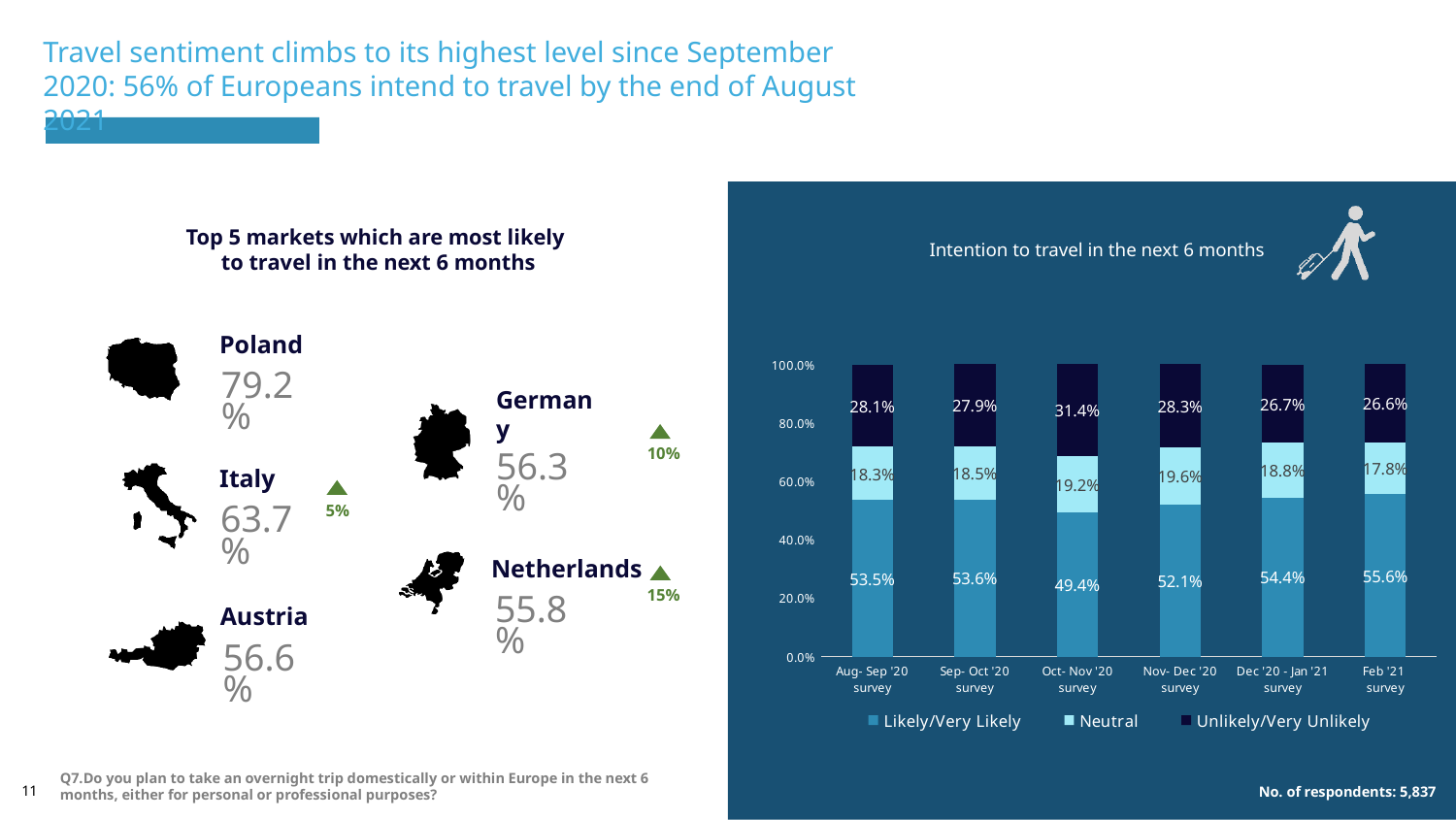
What is the Neutral value for the Nov- Dec '20 survey? 19.6% Which survey period has the lowest Likely/Very Likely value? Oct- Nov '20 survey How many series does the chart legend list? 3 Does the Likely/Very Likely value rise or fall from the Oct- Nov '20 survey to the Feb '21 survey? Rise Which is larger: the Neutral value for the Sep- Oct '20 survey or the Neutral value for the Feb '21 survey? Sep- Oct '20 survey What is the title of the chart? Intention to travel in the next 6 months How many survey periods are shown on the x axis of the chart? 6 What is the difference between the Likely/Very Likely values for the Feb '21 survey and the Aug- Sep '20 survey? 2.1% What is the Unlikely/Very Unlikely value for the Oct- Nov '20 survey? 31.4% Which survey period has the highest Unlikely/Very Unlikely value? Oct- Nov '20 survey What is the Likely/Very Likely value for the Feb '21 survey? 55.6% What type of chart is shown on the slide? Stacked bar chart